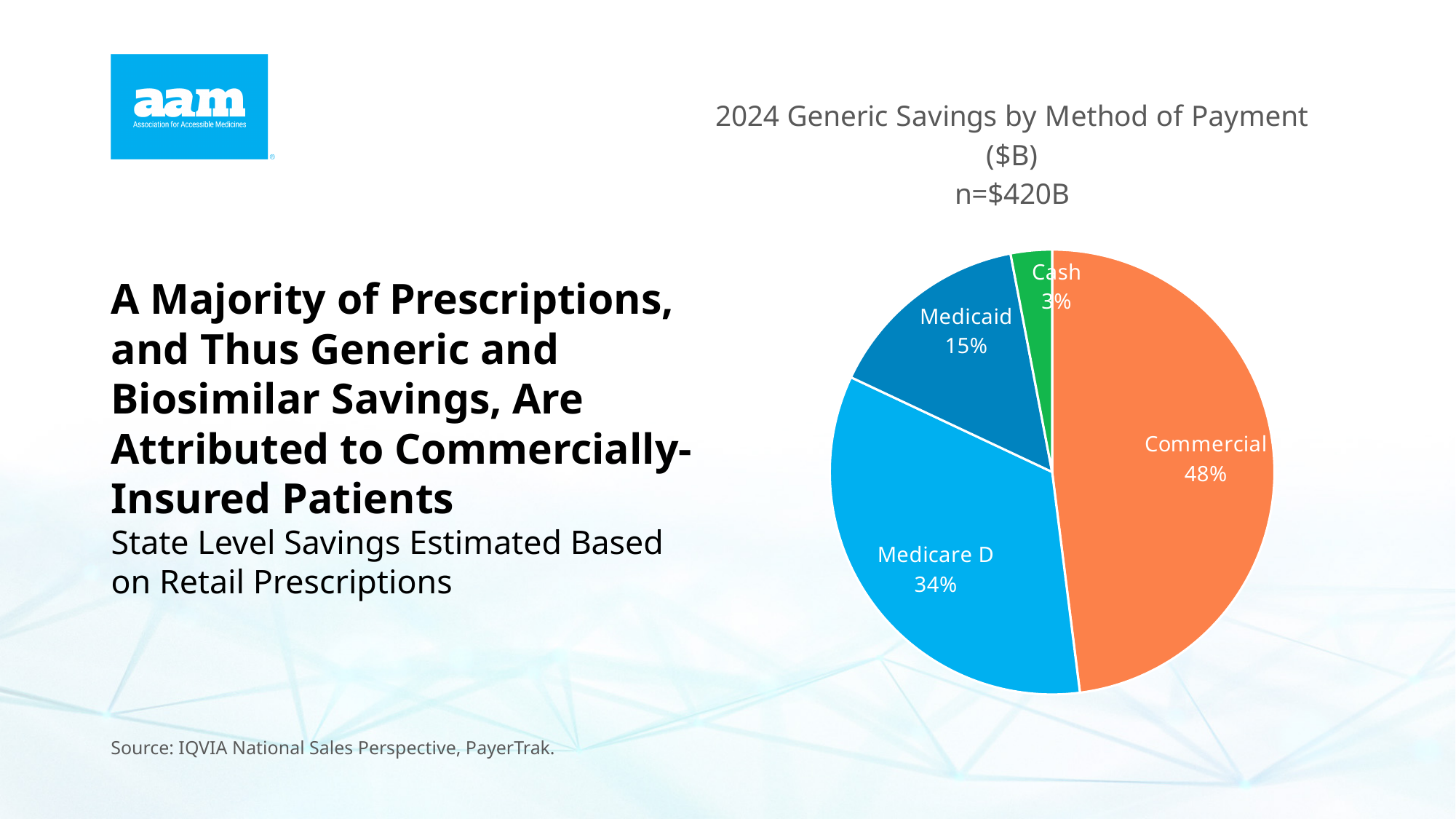
What is the title of the chart? 2024 Generic Savings by Method of Payment ($B) n=$420B What share of the pie does Medicare D account for? 34% How many slices does the pie chart have? 4 Which has a larger share, Medicaid or Medicare D? Medicare D What percentage of generic savings is attributed to Medicaid? 15% What is the difference in percentage points between the Commercial and Medicare D shares? 14 Which method of payment has the smallest share of generic savings? Cash What share of the pie is Cash? 3% What kind of chart is shown on the slide? Pie chart What colour is the Commercial slice of the pie? Orange Which method of payment has the largest share of generic savings? Commercial What share of 2024 generic savings is attributed to Commercial payment? 48%